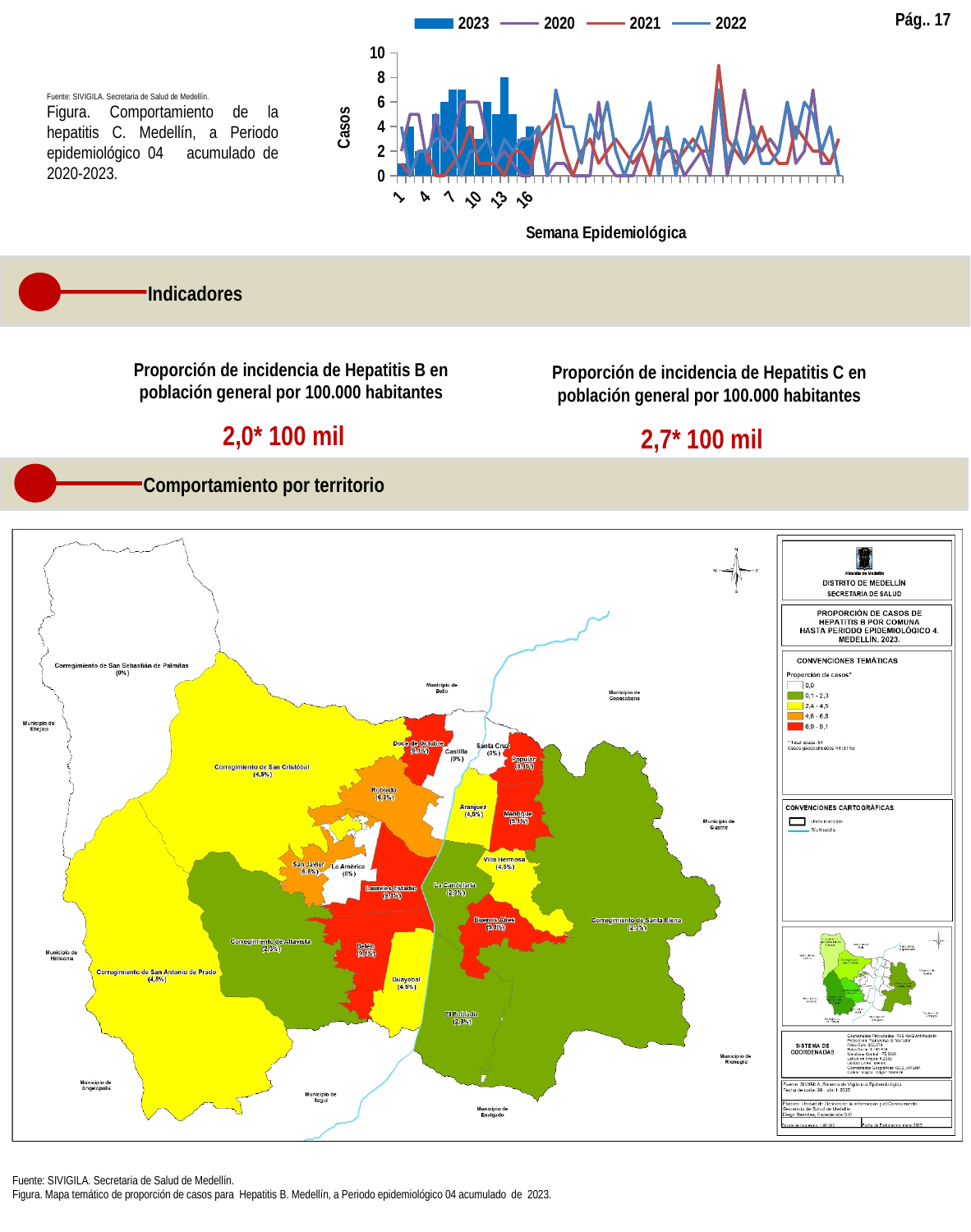
What is the maximum value shown on the vertical axis of the top chart? 10 Which series reaches the highest single value in the top chart? 2021 What kind of chart is shown at the top of the slide? A combined bar and line chart How many series does the legend of the top chart list? 4 Is the 2023 bar at week 1 in the top chart greater or less than 2? less Which series in the top chart is drawn as bars rather than a line? 2023 Is the 2023 bar at week 13 in the top chart greater or less than 6? greater What is the label of the vertical axis of the top chart? Casos Which series in the top chart is drawn in red? 2021 What is the label of the horizontal axis of the top chart? Semana Epidemiológica Is the peak value of the 2021 line in the top chart greater or less than 8? greater